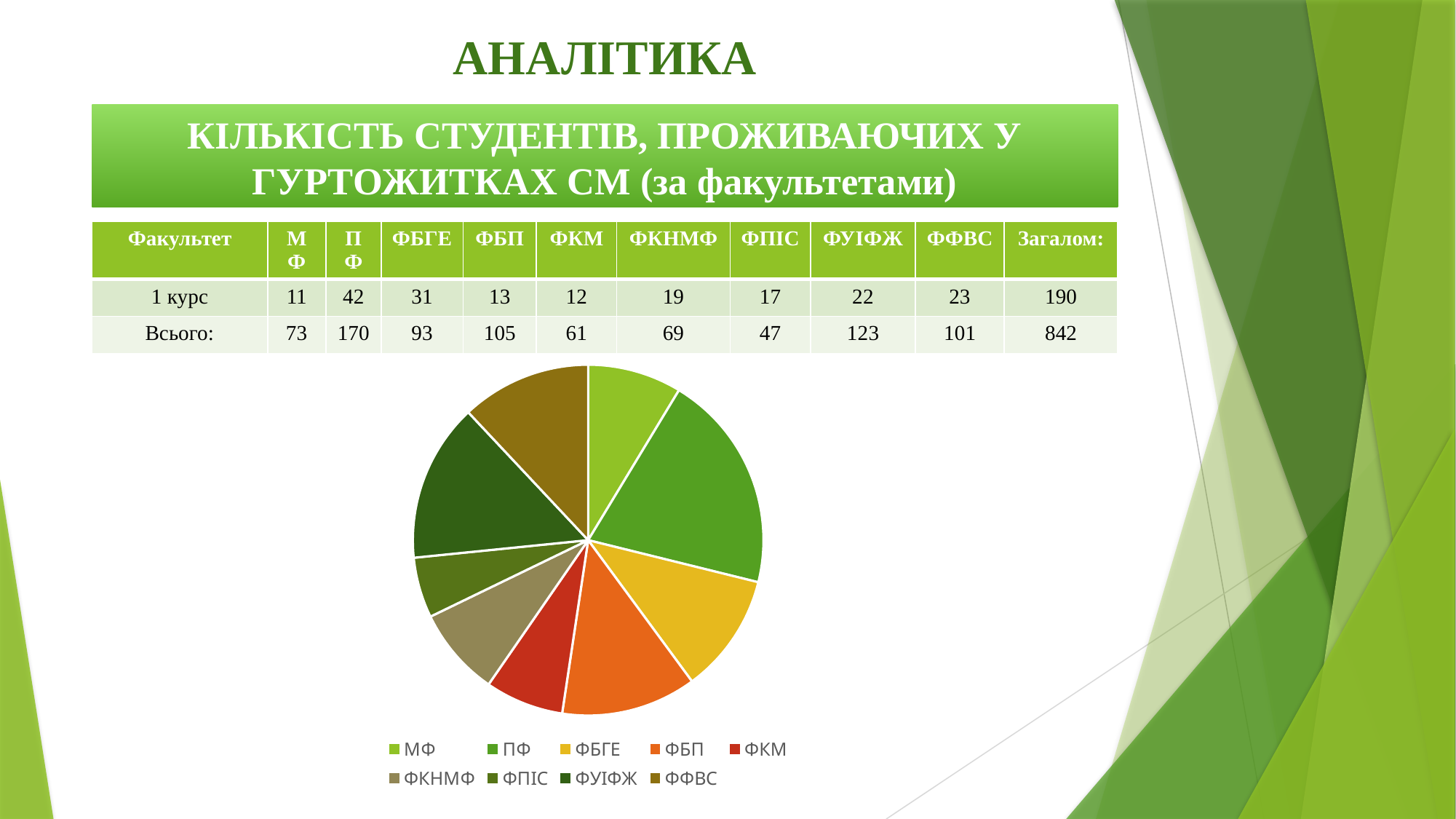
How many slices does the pie chart have? 9 Which legend entry is listed first in the pie chart's legend? МФ In the pie chart, which slice is larger: ФУІФЖ or ФКНМФ? ФУІФЖ What kind of chart is shown on the slide? pie chart In the pie chart, which slice is larger: ФФВС or ФПІС? ФФВС In the pie chart, which slice is larger: ПФ or ФБГЕ? ПФ How many entries does the pie chart's legend list? 9 Which faculty has the largest slice in the pie chart? ПФ Where is the legend positioned relative to the pie chart? below the chart